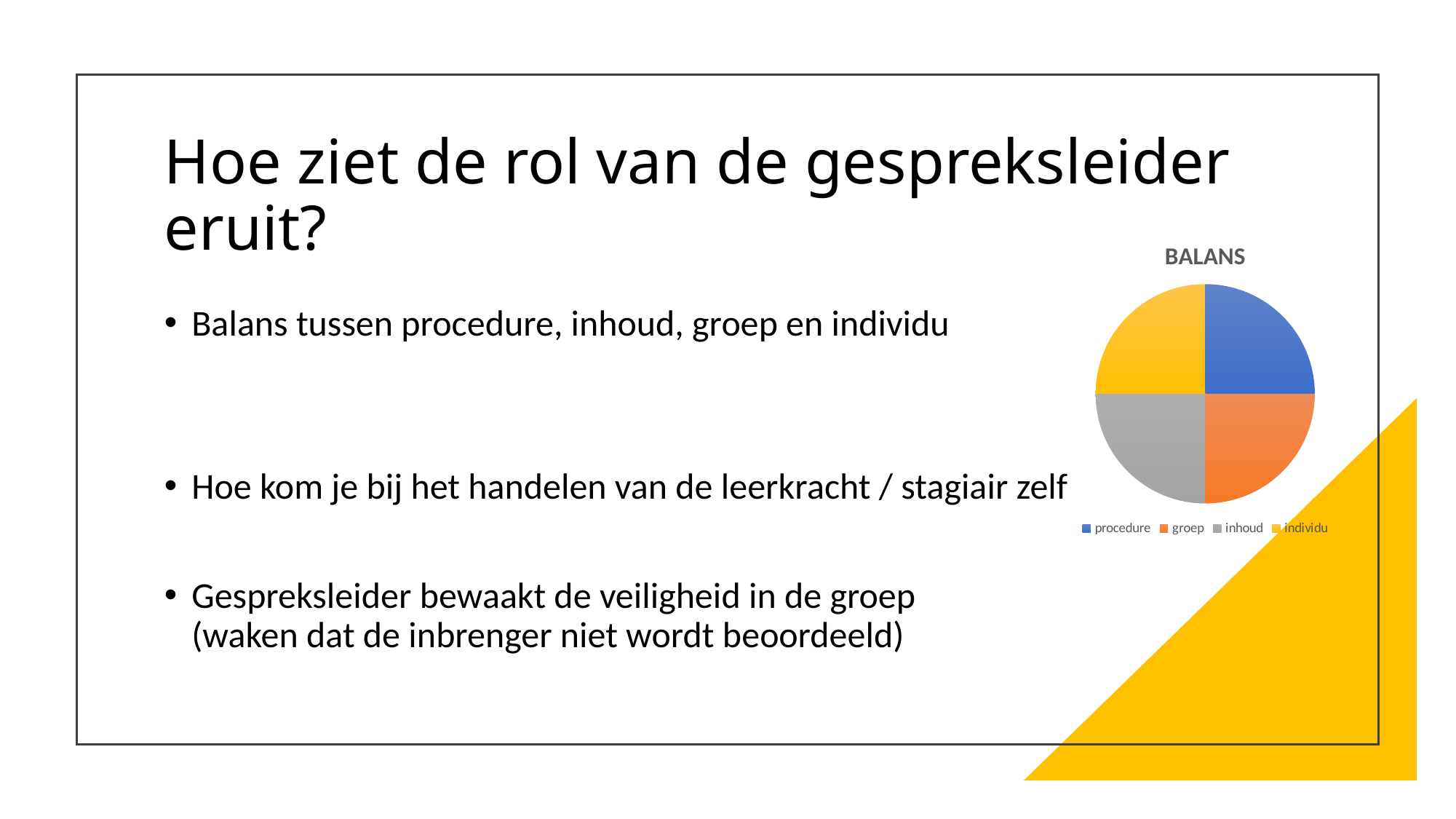
How many entries does the legend of the pie chart list? 4 Which category in the pie chart is shown in orange? groep What kind of chart is shown on the slide? pie chart Which category in the pie chart is shown in grey? inhoud What is the title of the pie chart? BALANS How many slices does the pie chart have? 4 Which category in the pie chart is shown in yellow? individu Which colour represents 'procedure' in the pie chart? blue